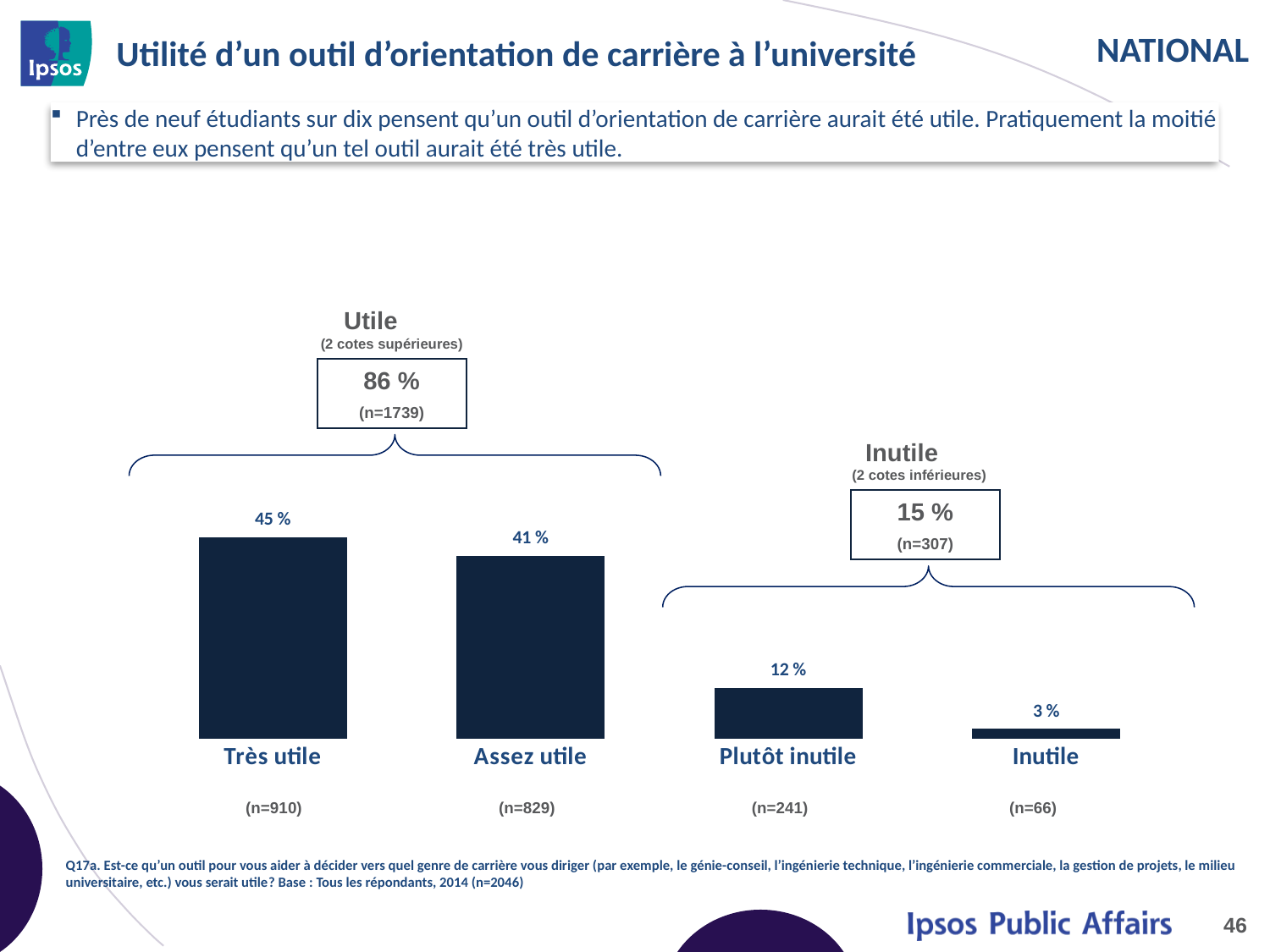
Which category has the highest value? Très utile What is the value for "Plutôt inutile"? 12 % How many categories are shown in the chart? 4 What is the difference between the values for "Très utile" and "Assez utile"? 4 % What is the value for "Très utile"? 45 % What is the value for "Inutile"? 3 % Which category has the lowest value? Inutile What is the value for "Assez utile"? 41 % What is the difference between the values for "Plutôt inutile" and "Inutile"? 9 % What is the combined percentage shown for the "Utile" group (2 cotes supérieures)? 86 % What kind of chart is shown on the slide? Bar chart Which is larger, the value for "Assez utile" or the value for "Plutôt inutile"? Assez utile